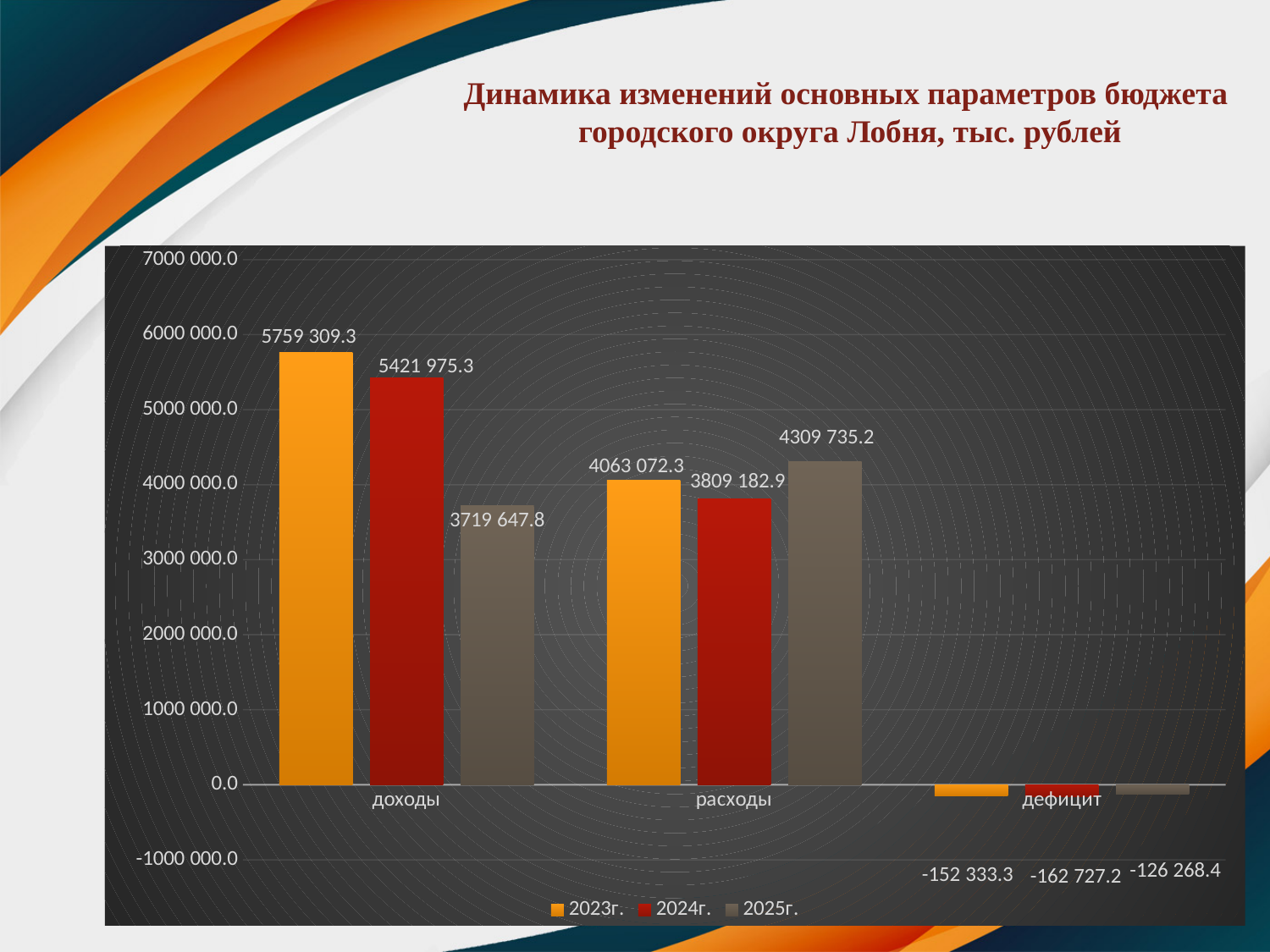
What is the value for расходы in 2025г.? 4309 735.2 What is the difference between доходы in 2023г. and доходы in 2024г.? 337 334.0 Is the value for доходы in 2025г. greater or less than 4000 000.0? less Which year has the highest value for доходы? 2023г. How many categories are shown on the x axis? 3 What is the difference between расходы in 2025г. and расходы in 2024г.? 500 552.3 Which is larger: доходы in 2025г. or расходы in 2025г.? расходы in 2025г. Which year has the lowest value for расходы? 2024г. What is the value for дефицит in 2024г.? -162 727.2 What is the value for доходы in 2023г.? 5759 309.3 What kind of chart is shown on the slide? bar chart How many series does the legend list? 3